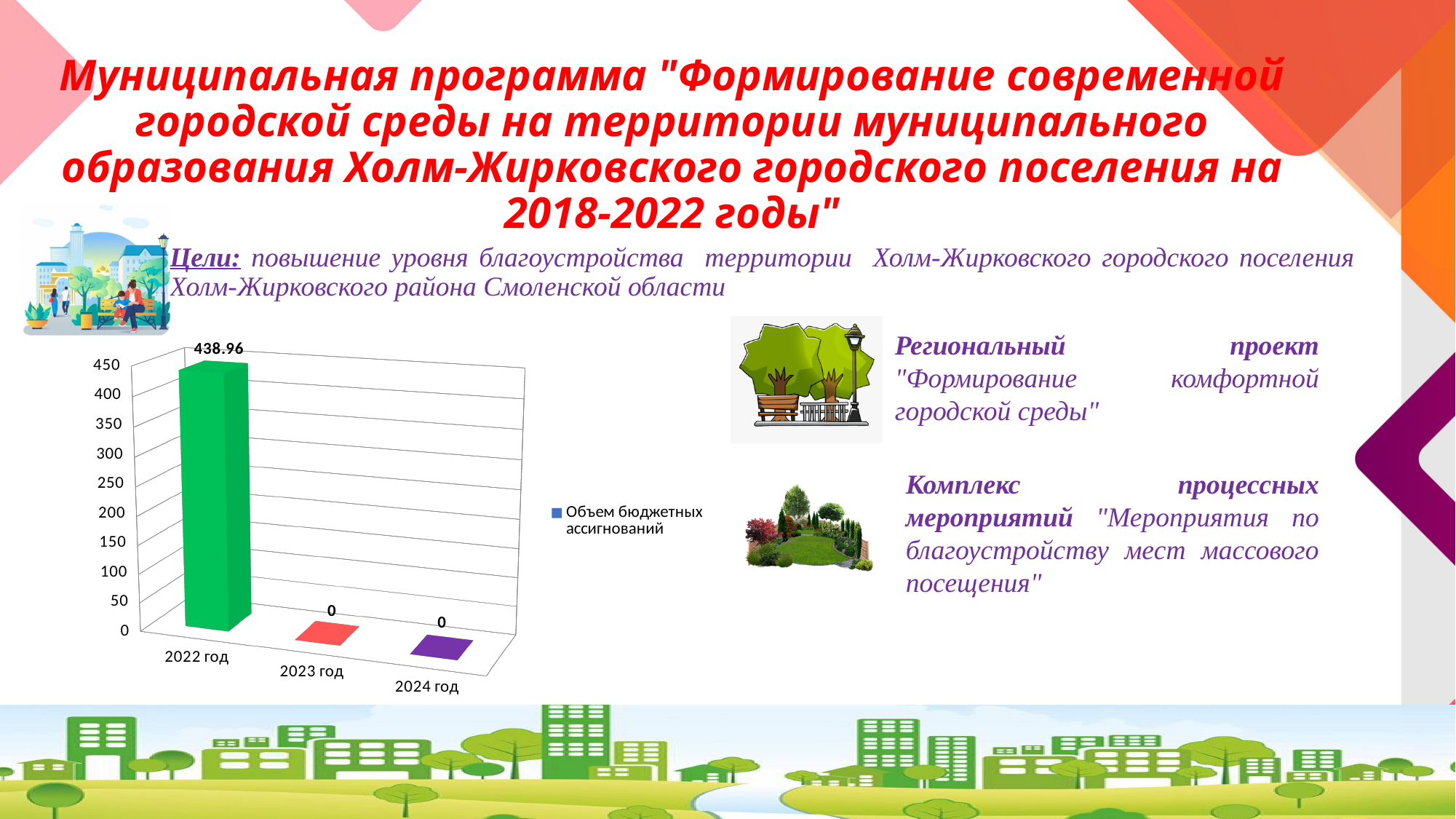
What is the value for 2022 год? 438.96 How many categories are shown on the x axis? 3 What is the value for 2024 год? 0 What kind of chart is shown? bar chart What is the difference between the values for 2022 год and 2023 год? 438.96 What is the series name shown in the legend? Объем бюджетных ассигнований What is the value for 2023 год? 0 Which is larger, the value for 2022 год or the value for 2024 год? 2022 год Is the value for 2022 год greater or less than 400? greater Do the values rise or fall from 2022 год to 2024 год? fall How many series does the legend list? 1 Which year has the highest value? 2022 год